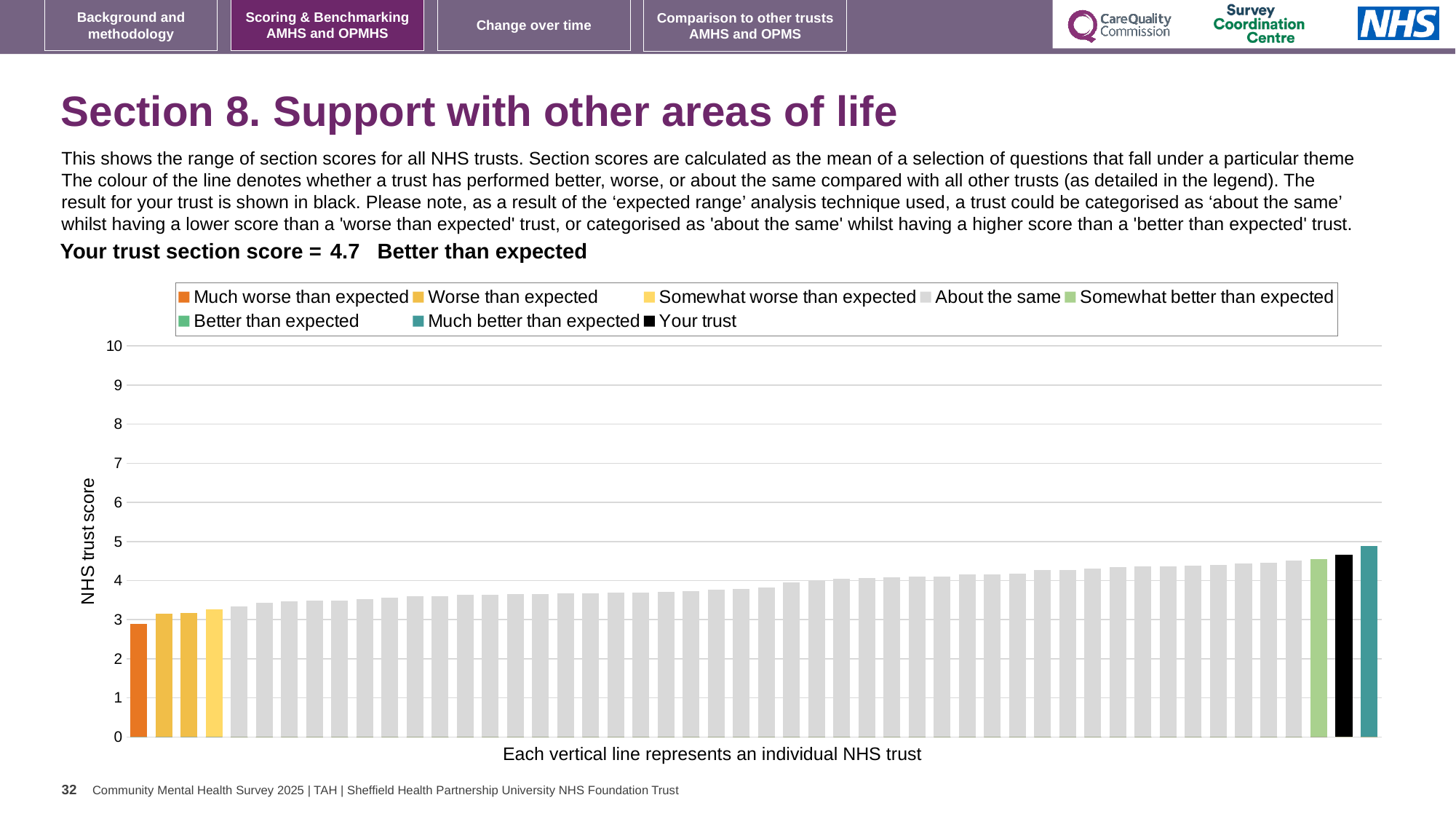
Which legend category does the lowest bar on the chart belong to? Much worse than expected Which is higher: the bar for your trust or the bar for the 'Much better than expected' trust? Much better than expected Is the value for your trust greater or less than 4? greater What kind of chart is shown on the slide? bar chart Which performance category is your trust placed in for this section? Better than expected Is the value of the lowest bar (the 'Much worse than expected' trust) greater or less than 4? less What is the label on the y axis of the chart? NHS trust score Is the value of the tallest bar greater or less than 4? greater What is the section score for your trust? 4.7 How many entries does the chart legend list? 8 Do the bar values rise or fall from left to right along the x axis? rise What colour is the bar representing your trust? black